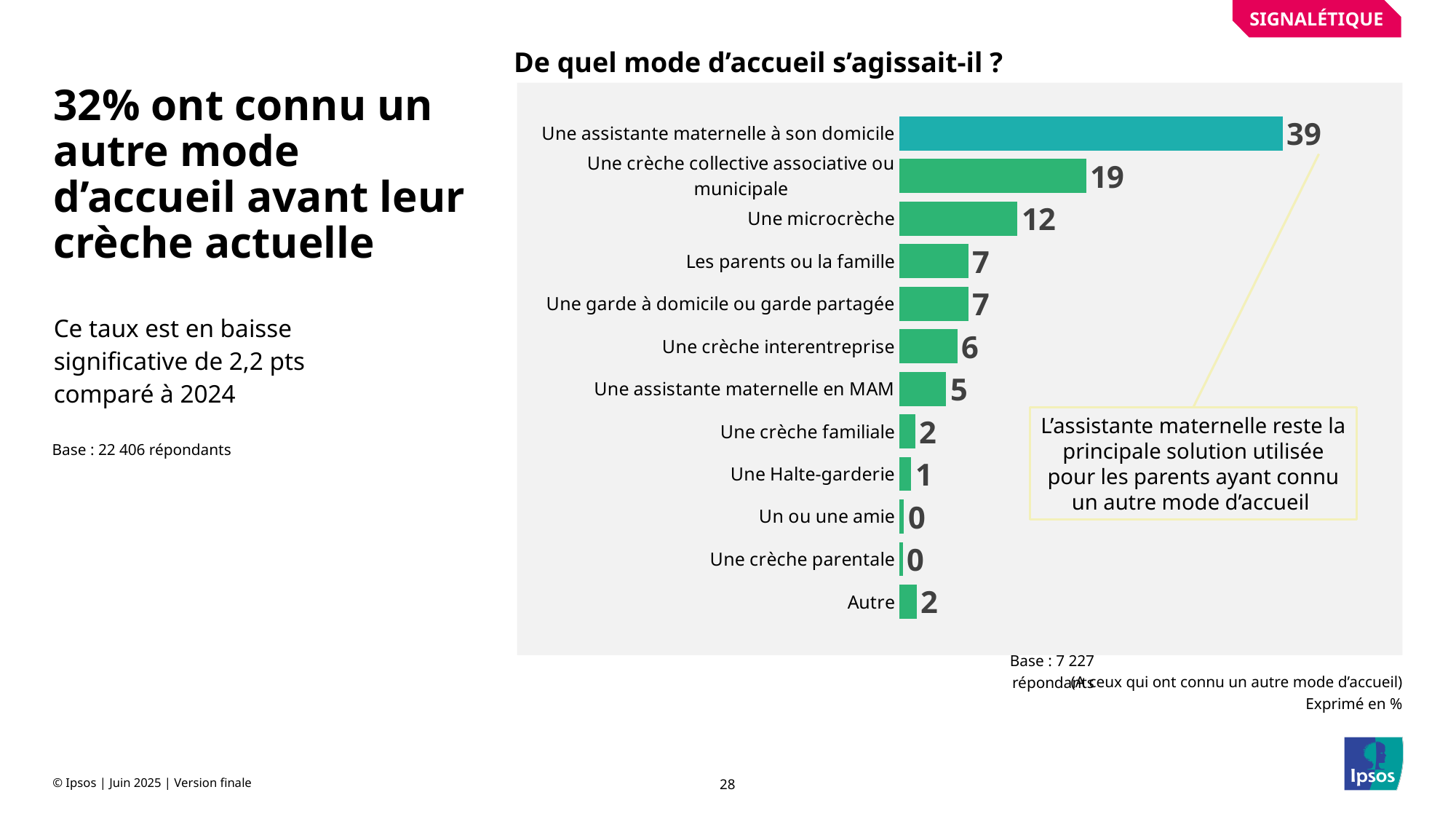
What is the title of the chart? De quel mode d'accueil s'agissait-il ? Which category has the highest value? Une assistante maternelle à son domicile Which is larger, the value for "Une crèche collective associative ou municipale" or the value for "Une microcrèche"? Une crèche collective associative ou municipale What is the difference between "Une assistante maternelle à son domicile" and "Une crèche collective associative ou municipale"? 20 What is the value for "Une crèche interentreprise"? 6 What kind of chart is shown on the slide? Bar chart What is the value for "Une microcrèche"? 12 How many categories are shown in the chart? 12 What is the value for "Une Halte-garderie"? 1 What is the difference between "Une microcrèche" and "Une assistante maternelle en MAM"? 7 What is the value for "Une assistante maternelle à son domicile"? 39 Which categories have a value of 0? Un ou une amie; Une crèche parentale